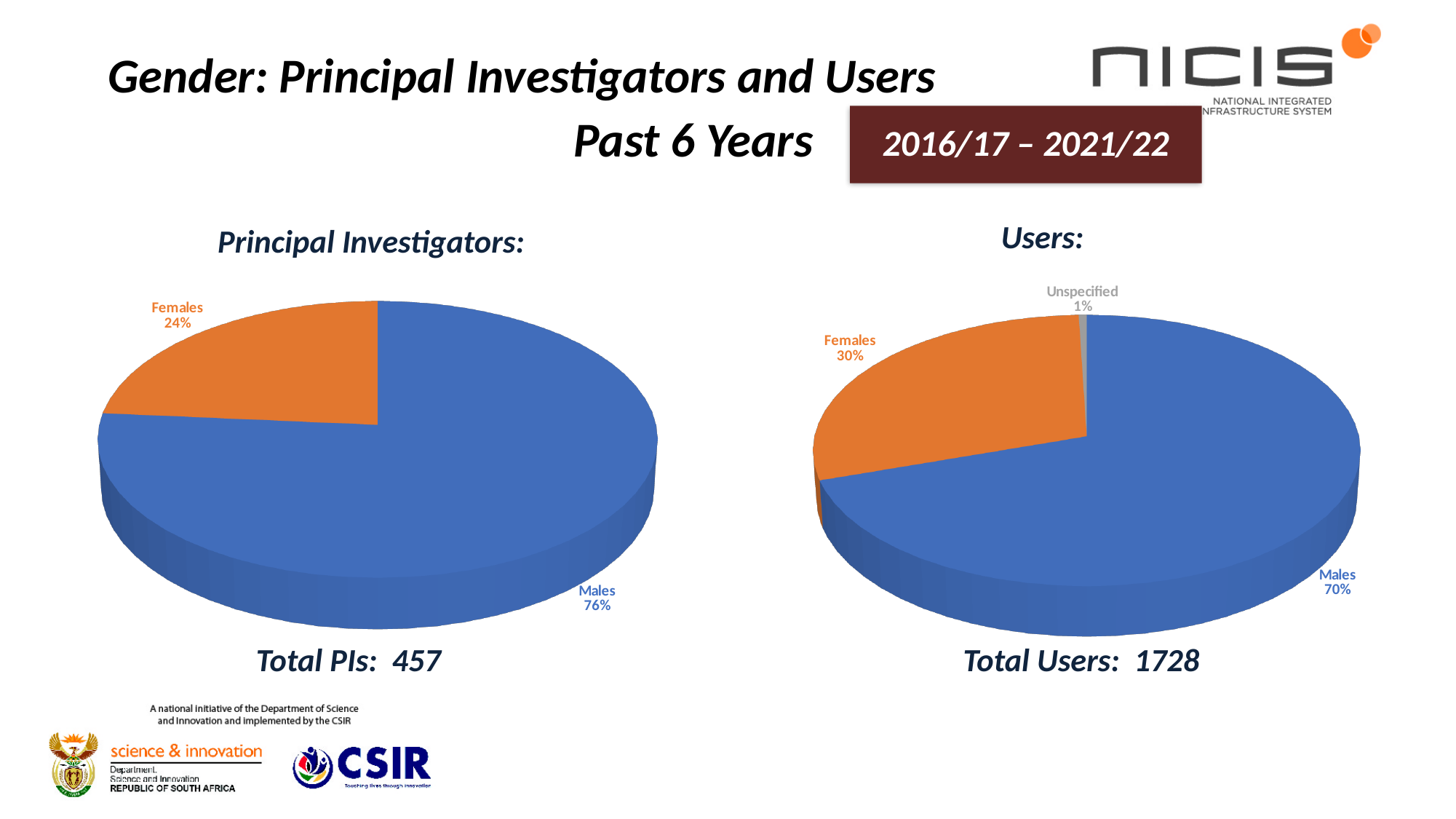
In the Users pie chart, what share of the pie is Males? 70% In the Users pie chart, what share of the pie is Unspecified? 1% How many slices does the Users pie chart have? 3 What kind of chart is the Principal Investigators chart? Pie chart In the Users pie chart, what share of the pie is Females? 30% In the Users pie chart, which category has the largest slice? Males In the Principal Investigators pie chart, which category has the largest slice? Males In the Users pie chart, which category has the smallest slice? Unspecified Is the Females share larger in the Principal Investigators chart or the Users chart? Users In the Principal Investigators pie chart, what is the difference in percentage points between Males and Females? 52